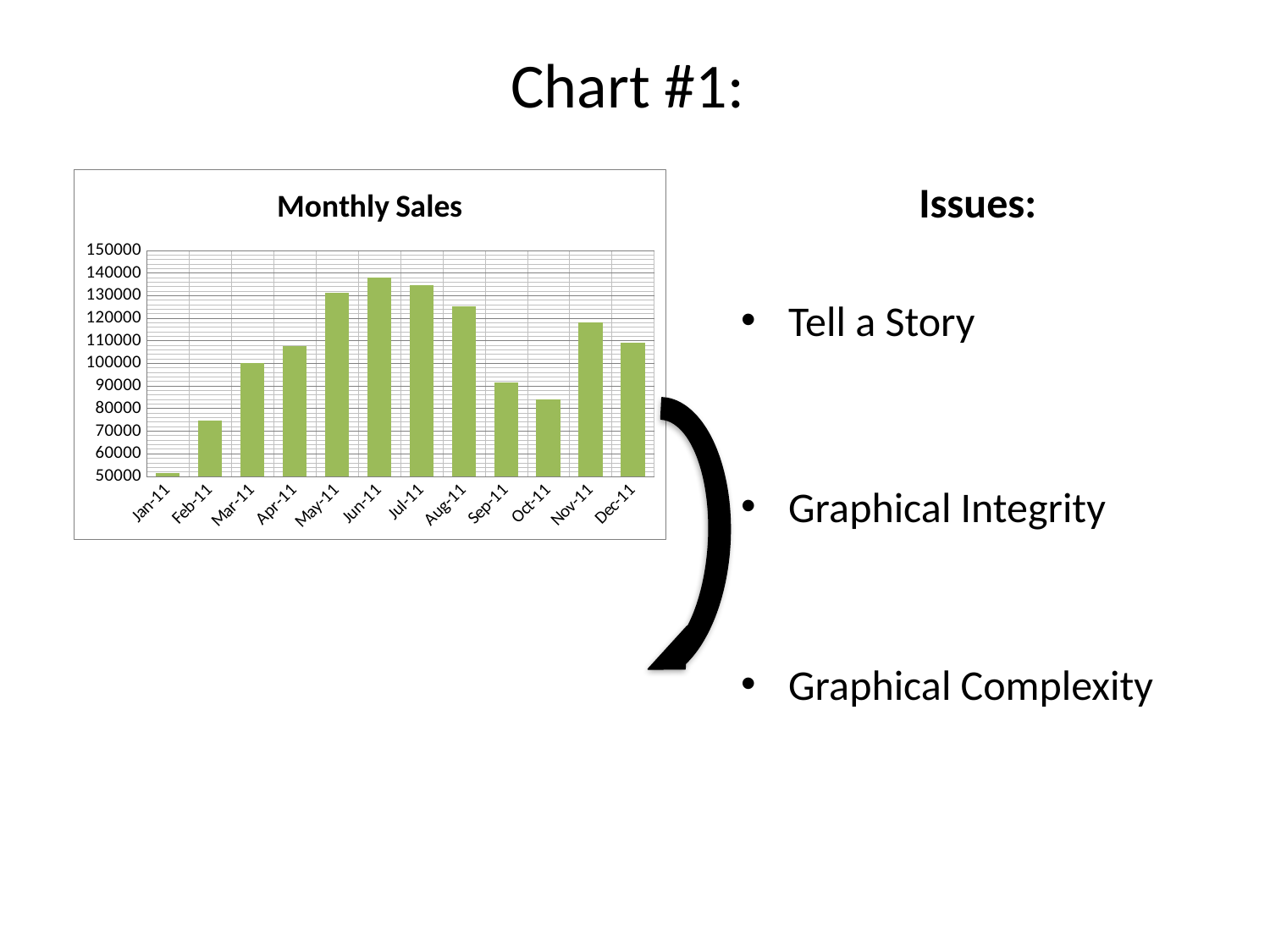
Which month has higher sales, Feb-11 or Oct-11? Oct-11 Do the sales values rise or fall from Jan-11 to Jun-11? rise Which month has the lowest sales in the chart? Jan-11 Is the value for Nov-11 greater or less than 110000? greater How many months are plotted in the Monthly Sales chart? 12 Is the value for Oct-11 greater or less than 90000? less Is the value for Aug-11 greater or less than 120000? greater What is the title of the chart? Monthly Sales Which month has higher sales, Nov-11 or Dec-11? Nov-11 Which month has the highest sales in the chart? Jun-11 What kind of chart is shown on the slide? bar chart